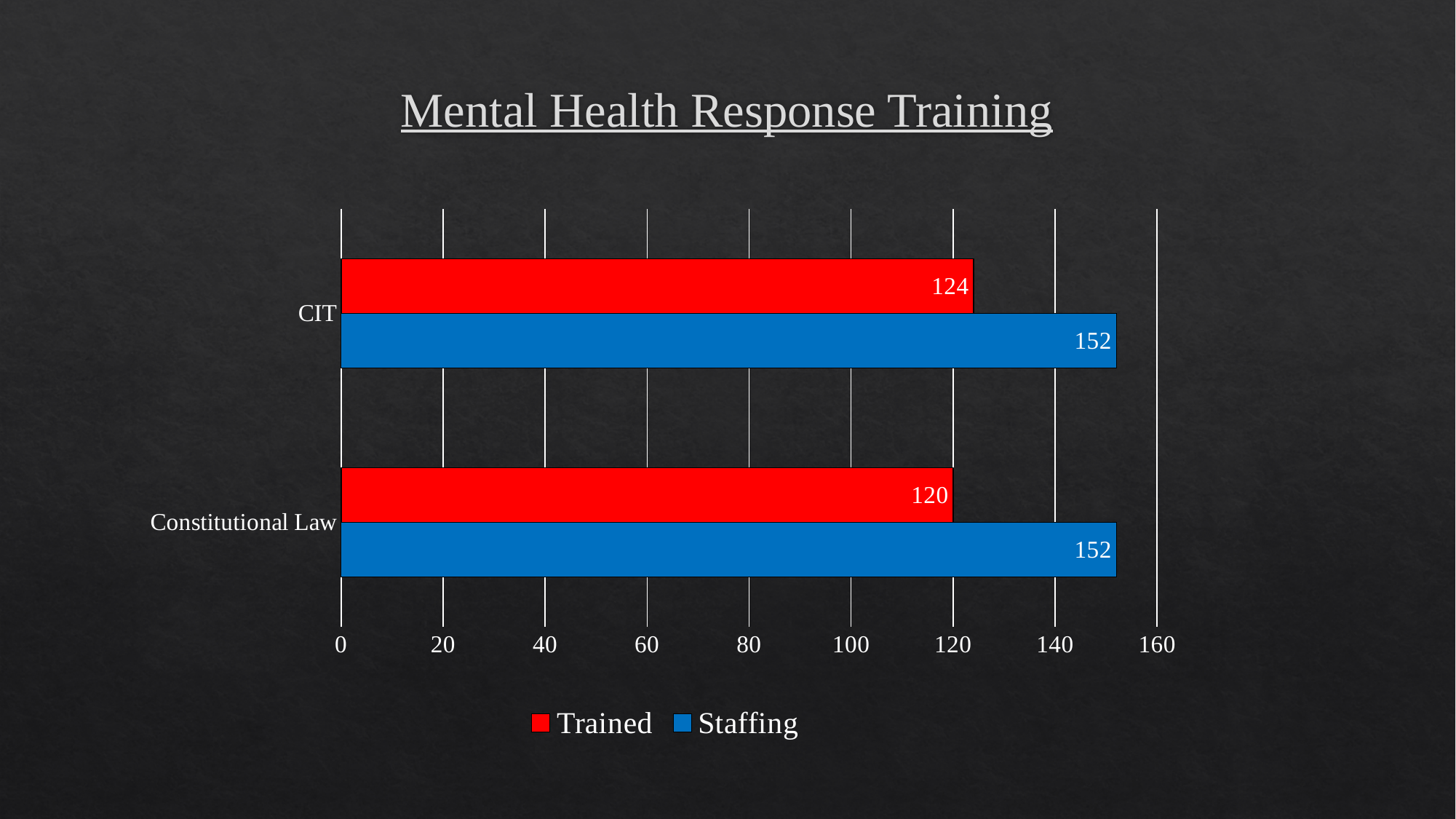
Which category has the higher Trained value? CIT How many categories are shown on the chart? 2 What is the Trained value for CIT? 124 What is the Staffing value for Constitutional Law? 152 How many series does the legend list? 2 What is the difference between the Staffing and Trained values for Constitutional Law? 32 Is the Trained value for CIT larger or smaller than the Staffing value for CIT? smaller Is the Trained value for Constitutional Law greater or less than 140? less What is the Staffing value for CIT? 152 What is the difference between the Staffing and Trained values for CIT? 28 What is the Trained value for Constitutional Law? 120 What kind of chart is shown on the slide? bar chart